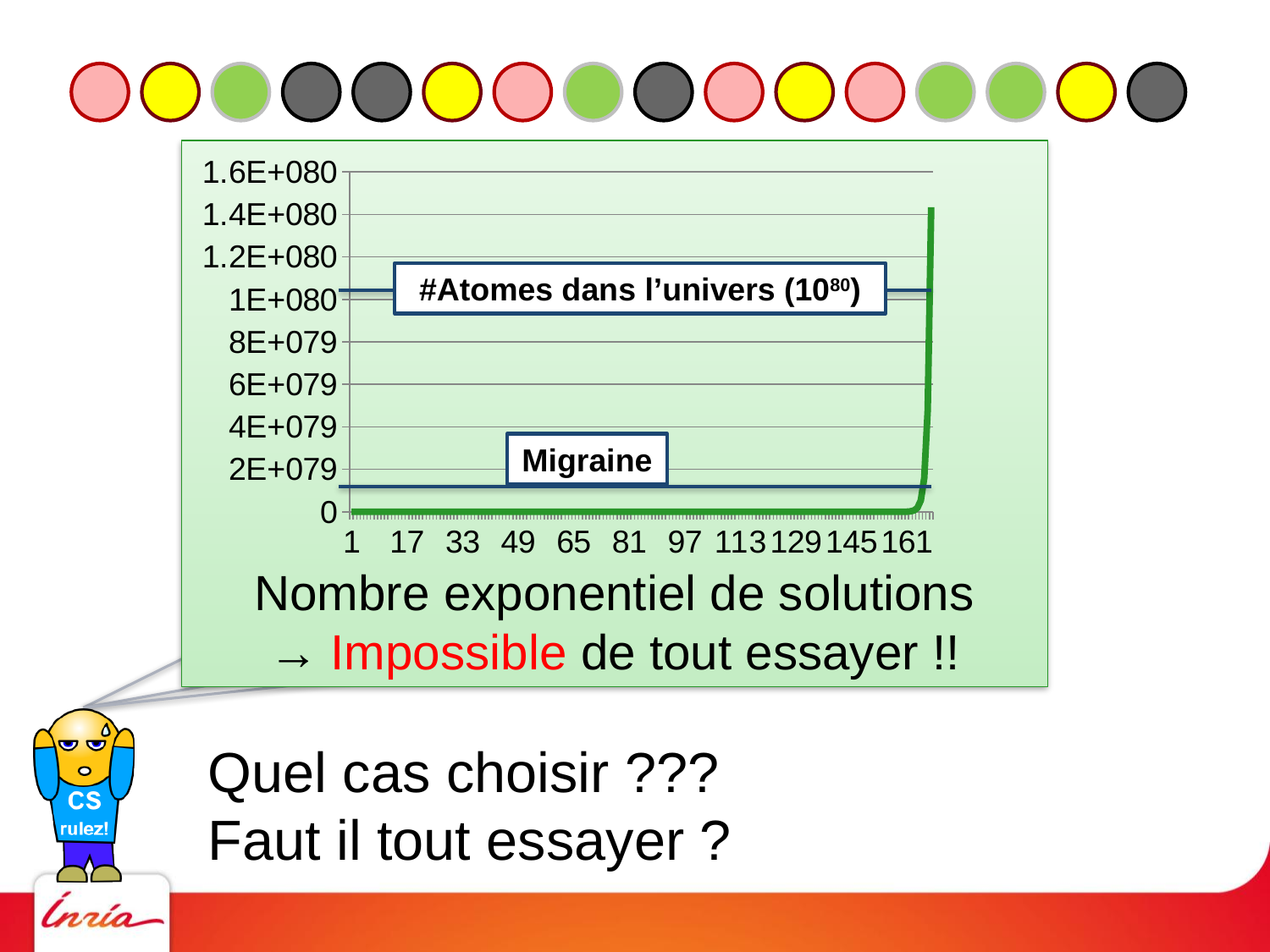
What is the highest tick value shown on the y axis? 1.6E+080 Does the green curve rise or fall as the x axis increases? rises Is the value of the 'Migraine' line greater or less than 2E+079? less What is the last tick label shown on the x axis? 161 Is the value of the green curve at x = 81 greater or less than 2E+079? less How many tick labels are shown on the x axis? 11 Which is higher on the chart, the '#Atomes dans l'univers' line or the 'Migraine' line? #Atomes dans l'univers What is the label of the lower horizontal line on the chart? Migraine What kind of chart is shown on the slide? line chart Is the peak value of the green curve greater or less than 1.2E+080? greater At what value on the y axis is the '#Atomes dans l'univers' line drawn? 1E+080 What is the label of the horizontal line drawn at 1E+080 on the chart? #Atomes dans l'univers (10^80)